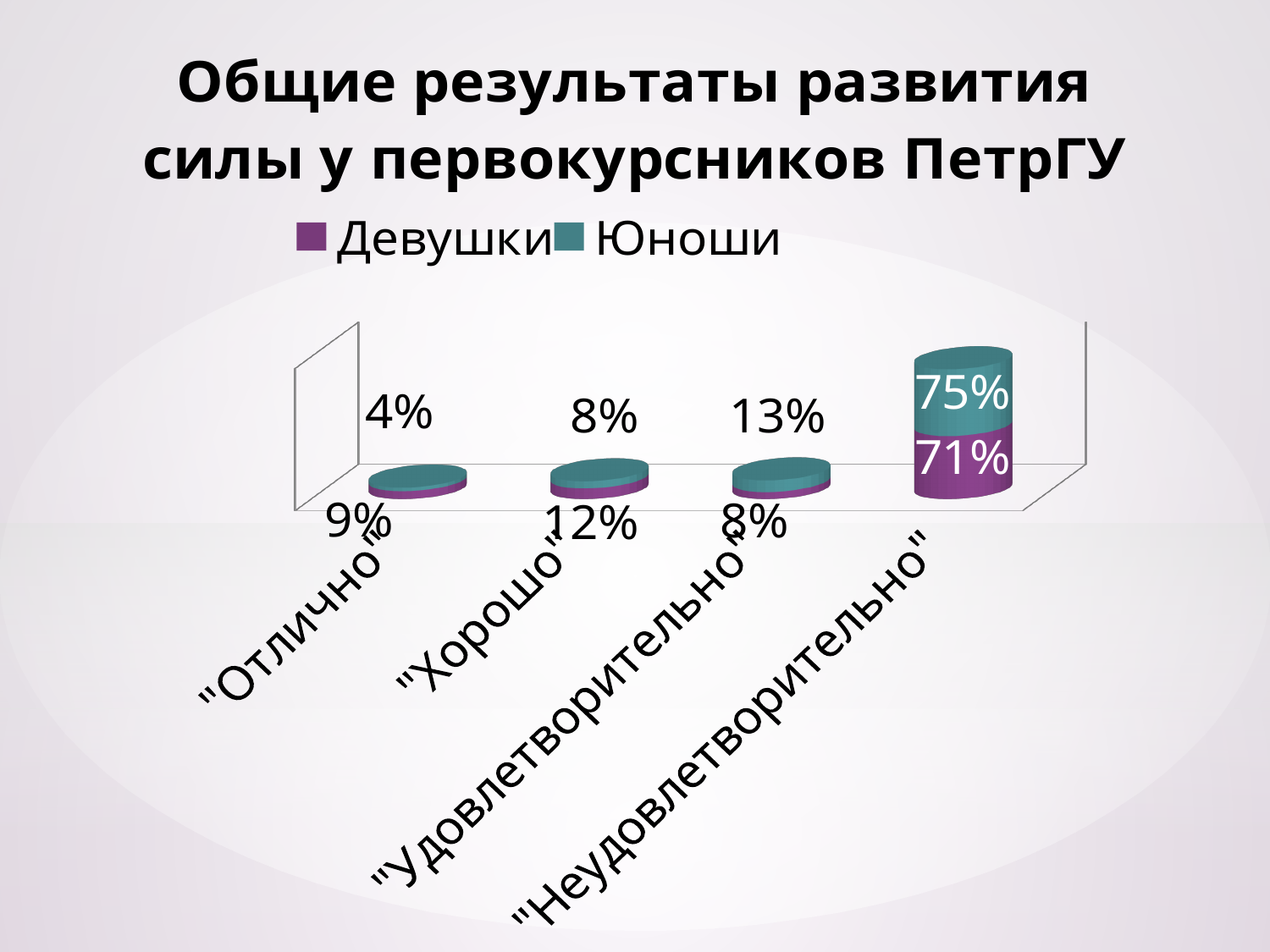
How many categories are shown on the x axis? 4 What is the total of the stacked bar for the "Хорошо" category? 20% What is the value for Девушки in the "Хорошо" category? 12% How many series does the legend list? 2 What is the value for Юноши in the "Удовлетворительно" category? 13% What kind of chart is shown on the slide? bar chart What is the value for Юноши in the "Неудовлетворительно" category? 75% Which category has the highest value for Юноши? "Неудовлетворительно" What is the difference between the Юноши and Девушки values in the "Неудовлетворительно" category? 4% Which category has the lowest value for Юноши? "Отлично" In the "Отлично" category, which series has the larger value, Девушки or Юноши? Девушки What is the value for Девушки in the "Неудовлетворительно" category? 71%